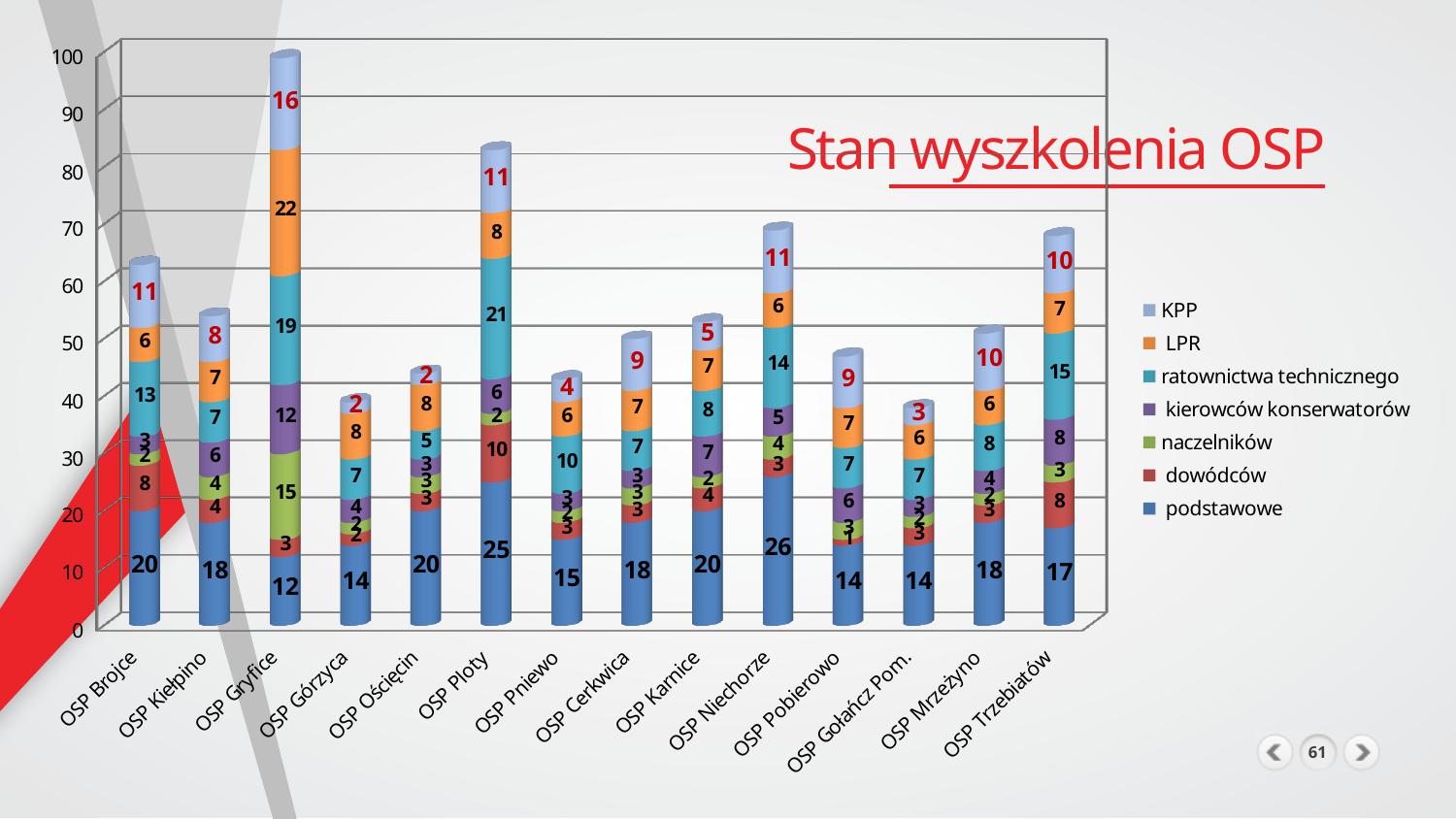
How many series does the legend list? 7 Which is larger: the 'podstawowe' value for OSP Płoty or for OSP Brojce? OSP Płoty How many OSP units are shown on the x axis? 14 What is the total of the stacked bar for OSP Gryfice? 99 What is the value of the 'podstawowe' series for OSP Niechorze? 26 What kind of chart is shown on the slide? stacked bar chart What is the difference between the LPR value for OSP Gryfice and the LPR value for OSP Brojce? 16 What is the 'ratownictwa technicznego' value for OSP Płoty? 21 Which OSP has the lowest 'podstawowe' value? OSP Gryfice Which OSP has the highest 'podstawowe' value? OSP Niechorze What is the KPP value for OSP Gryfice? 16 Is the total height of the OSP Gryfice bar greater or less than 90? greater